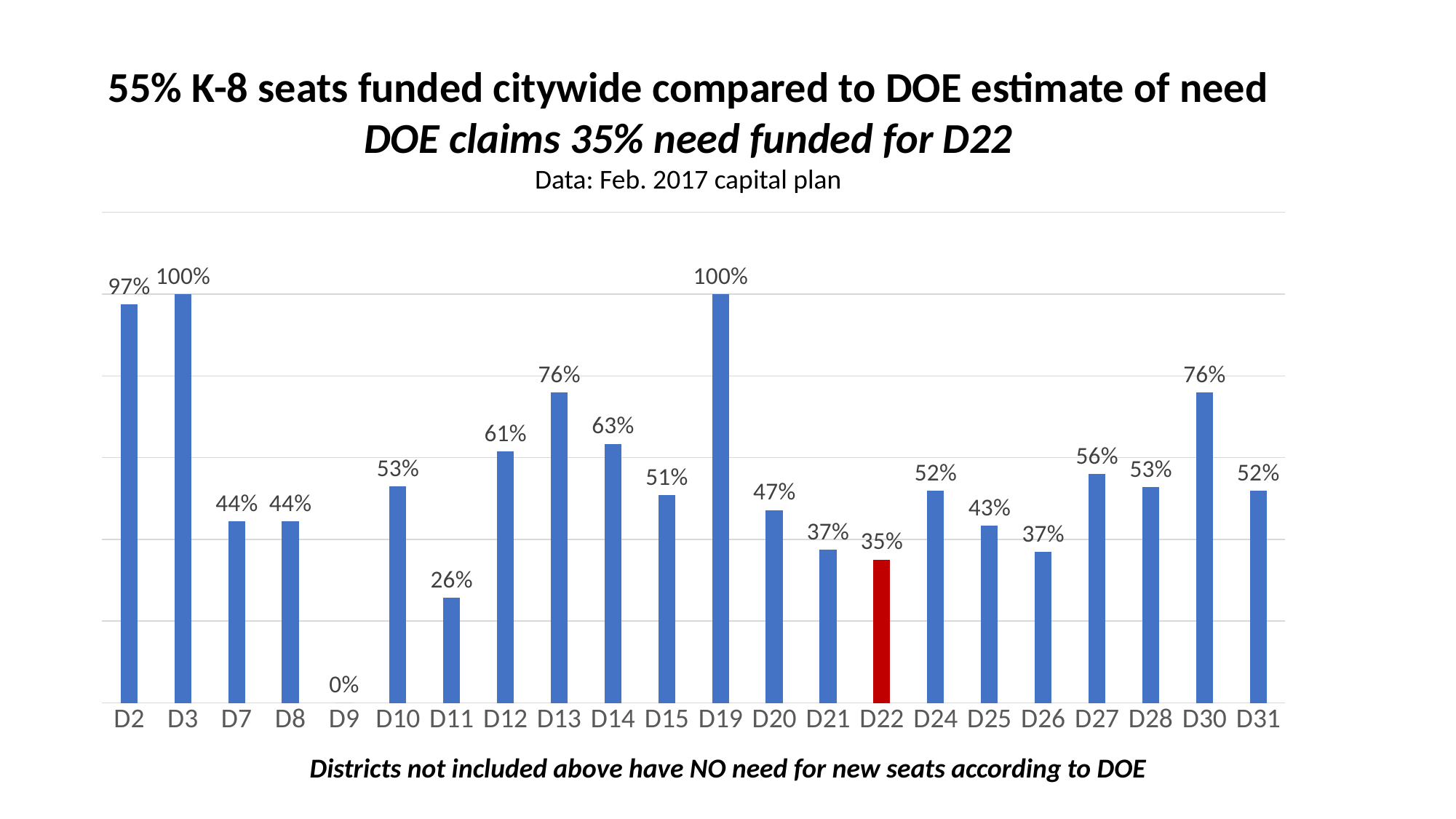
What data source is cited below the chart title? Feb. 2017 capital plan What is the value for D22? 35% Which is larger, the value for D14 or the value for D20? D14 What is the difference between the values for D2 and D22? 62% What kind of chart is this? Bar chart What is the value for D13? 76% What is the difference between the values for D30 and D31? 24% Which districts share the highest value of 100%? D3 and D19 What is the value for D11? 26% Which district's bar is coloured red? D22 How many districts are shown on the x axis? 22 Which district has the lowest value? D9